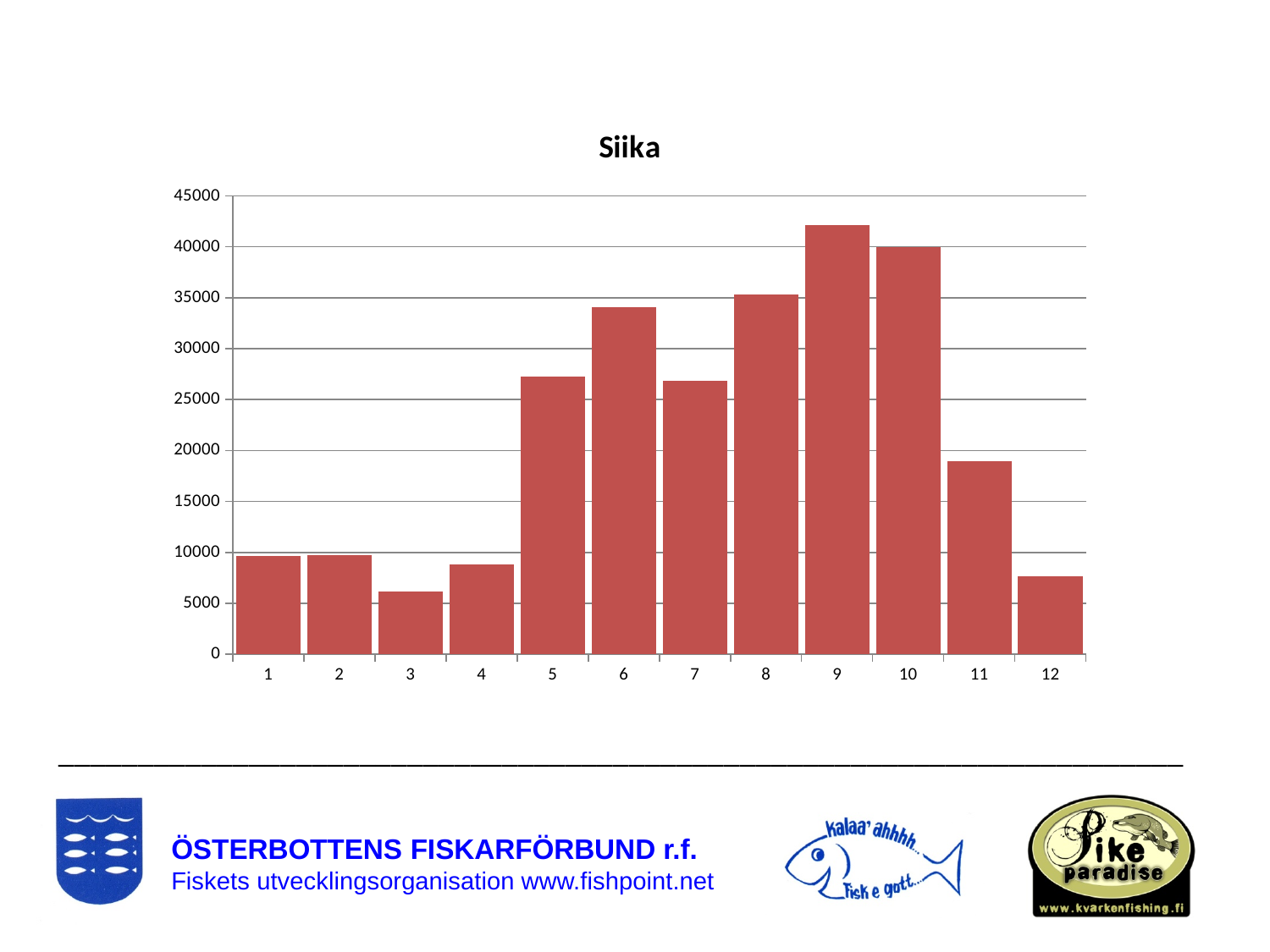
What kind of chart is shown on the slide? bar chart Is the value for category 3 greater or less than 5000? greater Which has the larger value, category 9 or category 10? 9 Which category has the highest value in the chart? 9 Is the value for category 11 greater or less than 20000? less Which has the larger value, category 11 or category 12? 11 Is the value for category 9 greater or less than 40000? greater Do the values rise or fall from category 9 to category 12? fall What is the title of the chart? Siika Which category has the lowest value in the chart? 3 How many categories are shown on the x axis of the chart? 12